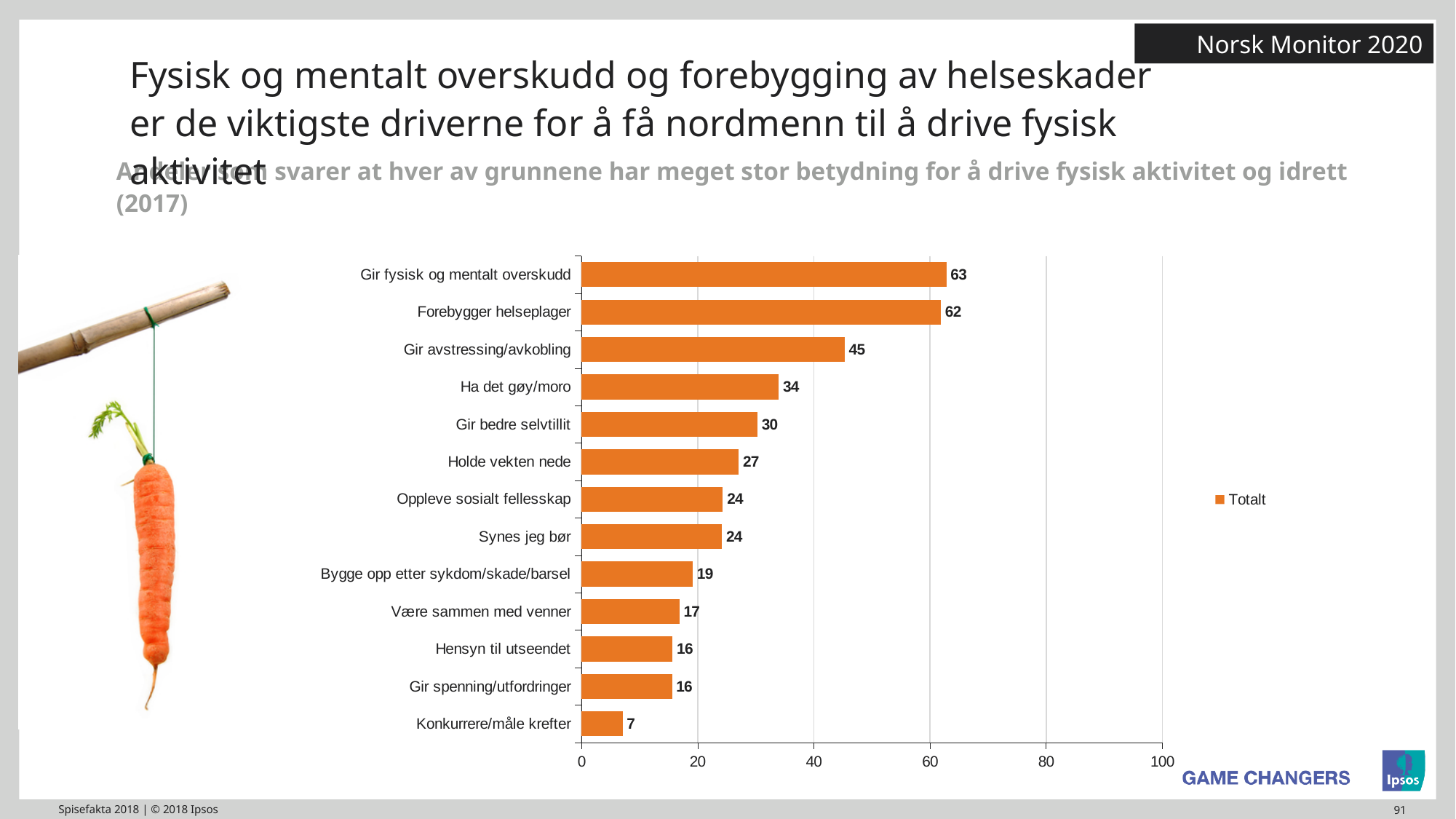
Which category has the highest value? Gir fysisk og mentalt overskudd What is the value for "Bygge opp etter sykdom/skade/barsel"? 19 What is the difference between the values for "Gir fysisk og mentalt overskudd" and "Ha det gøy/moro"? 29 How many categories are shown in the chart? 13 Is the value for "Forebygger helseplager" greater or less than 60? greater Which is larger, the value for "Gir bedre selvtillit" or the value for "Være sammen med venner"? Gir bedre selvtillit What kind of chart is shown on the slide? bar chart Which category has the lowest value? Konkurrere/måle krefter How many series does the legend list? 1 What is the name of the series shown in the legend? Totalt What is the value for "Gir avstressing/avkobling"? 45 What is the value for "Holde vekten nede"? 27